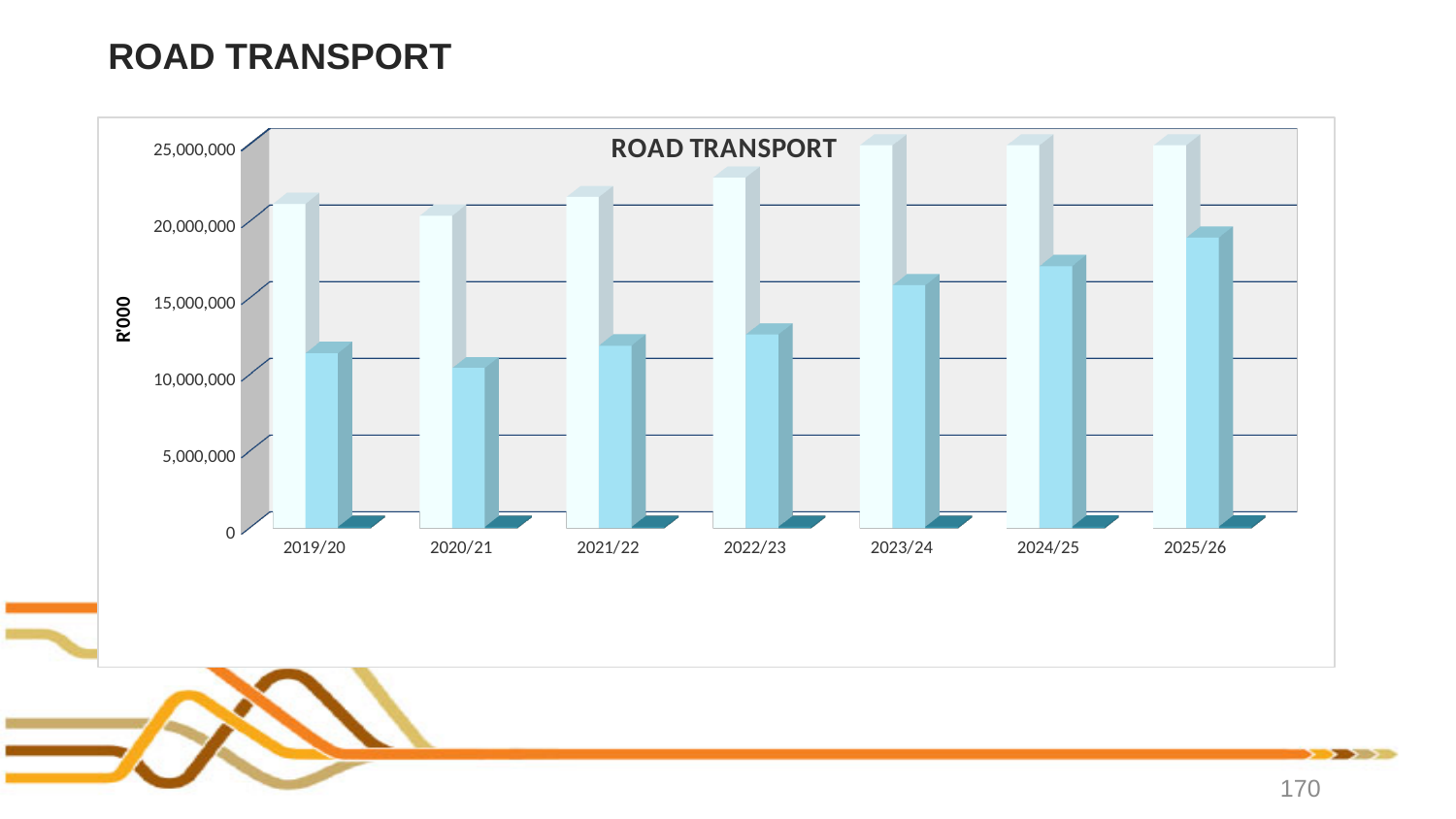
How many financial years are shown on the x axis of the chart? 7 In which year is the medium blue bar the lowest? 2020/21 In which year is the medium blue bar the highest? 2025/26 Is the value of the medium blue bar for 2020/21 greater or less than 15,000,000? less What kind of chart is shown on the slide? bar chart Is the value of the light-coloured bar for 2023/24 greater or less than 20,000,000? greater Which is larger, the medium blue bar for 2019/20 or the medium blue bar for 2025/26? 2025/26 Do the medium blue bars generally rise or fall from 2020/21 to 2025/26? rise Is the value of the medium blue bar for 2023/24 greater or less than 10,000,000? greater What is the label on the vertical axis of the chart? R'000 What is the title of the chart? ROAD TRANSPORT